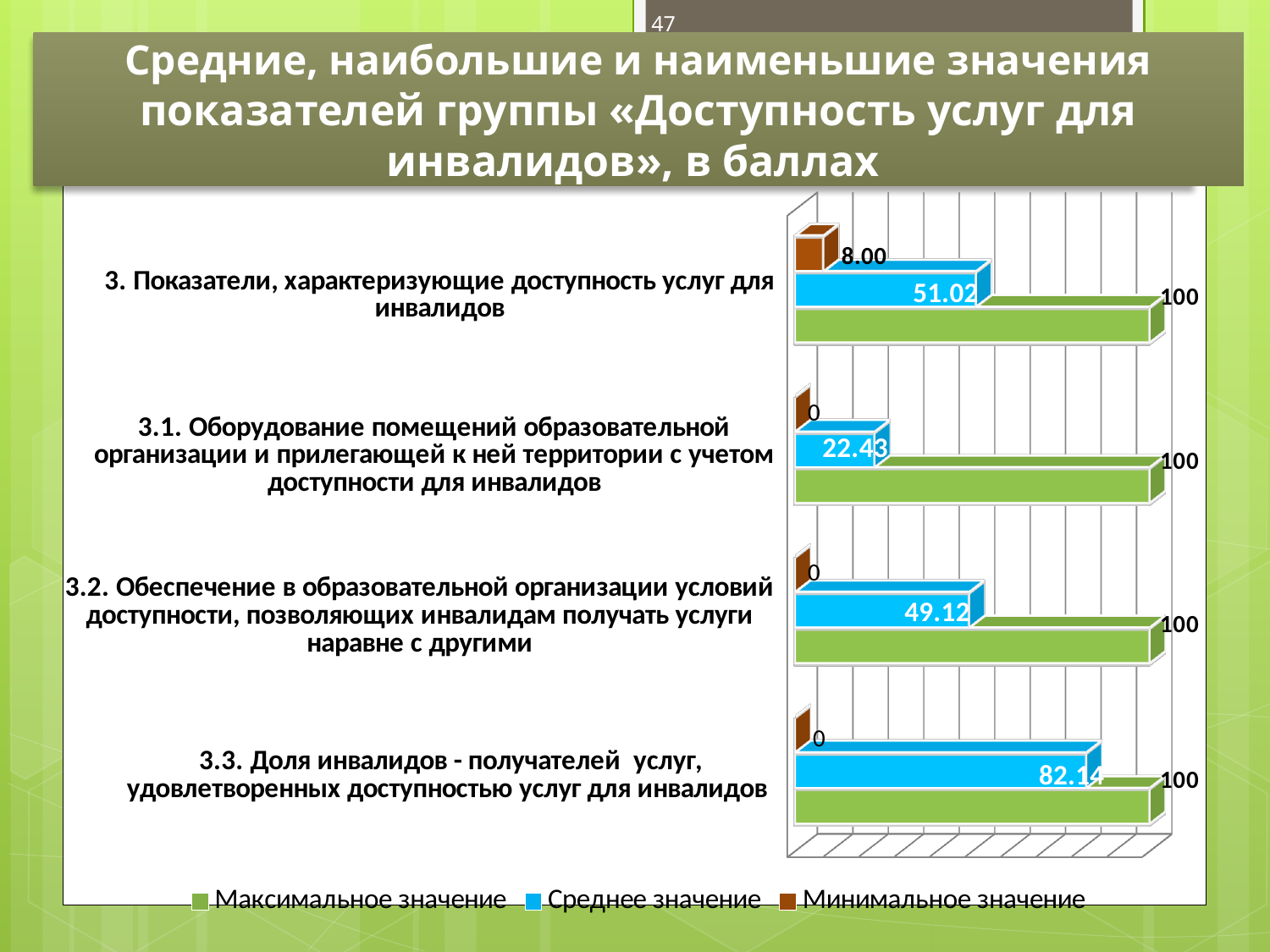
What is the average value (Среднее значение) for indicator 3.3 «Доля инвалидов - получателей услуг, удовлетворенных доступностью услуг для инвалидов»? 82.14 How many series does the legend list? 3 What is the difference between the maximum and average values for indicator 3.2? 50.88 Which is larger: the average value for indicator 3 or the average value for indicator 3.2? Indicator 3 (51.02) What type of chart is shown on the slide? Bar chart What is the average value (Среднее значение) for indicator 3.1 «Оборудование помещений образовательной организации...»? 22.43 Which indicator has the lowest average value (Среднее значение)? 3.1. Оборудование помещений образовательной организации и прилегающей к ней территории с учетом доступности для инвалидов What is the minimum value (Минимальное значение) for indicator 3 «Показатели, характеризующие доступность услуг для инвалидов»? 8.00 How many indicators (categories) are shown in the chart? 4 What is the maximum value (Максимальное значение) for indicator 3.2? 100 What is the difference between the average values of indicator 3.3 and indicator 3.1? 59.71 Which indicator has the highest average value (Среднее значение)? 3.3. Доля инвалидов - получателей услуг, удовлетворенных доступностью услуг для инвалидов